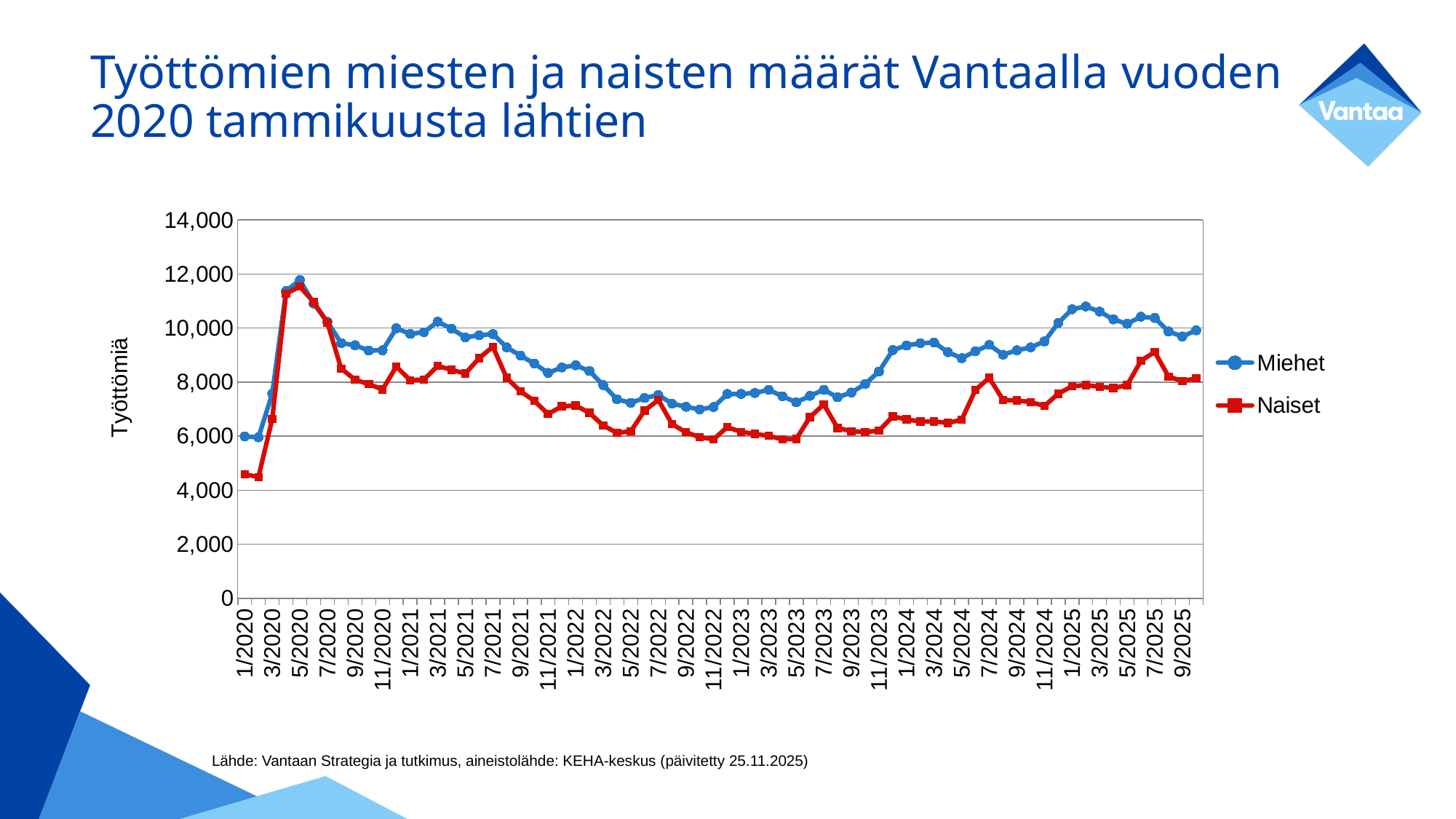
Is the value for Naiset at 7/2025 greater or less than 8,000? greater What kind of chart is shown on the slide? line chart Which series reaches the highest value anywhere on the chart? Miehet What are the two series named in the legend? Miehet and Naiset What is the label on the vertical axis? Työttömiä Is the value for Miehet at 1/2025 greater or less than 10,000? greater Is the value for Naiset at 1/2020 greater or less than 6,000? less How many series does the legend list? 2 Which series has the larger value at 1/2024, Miehet or Naiset? Miehet Do the values for Naiset rise or fall between 5/2023 and 7/2025? rise